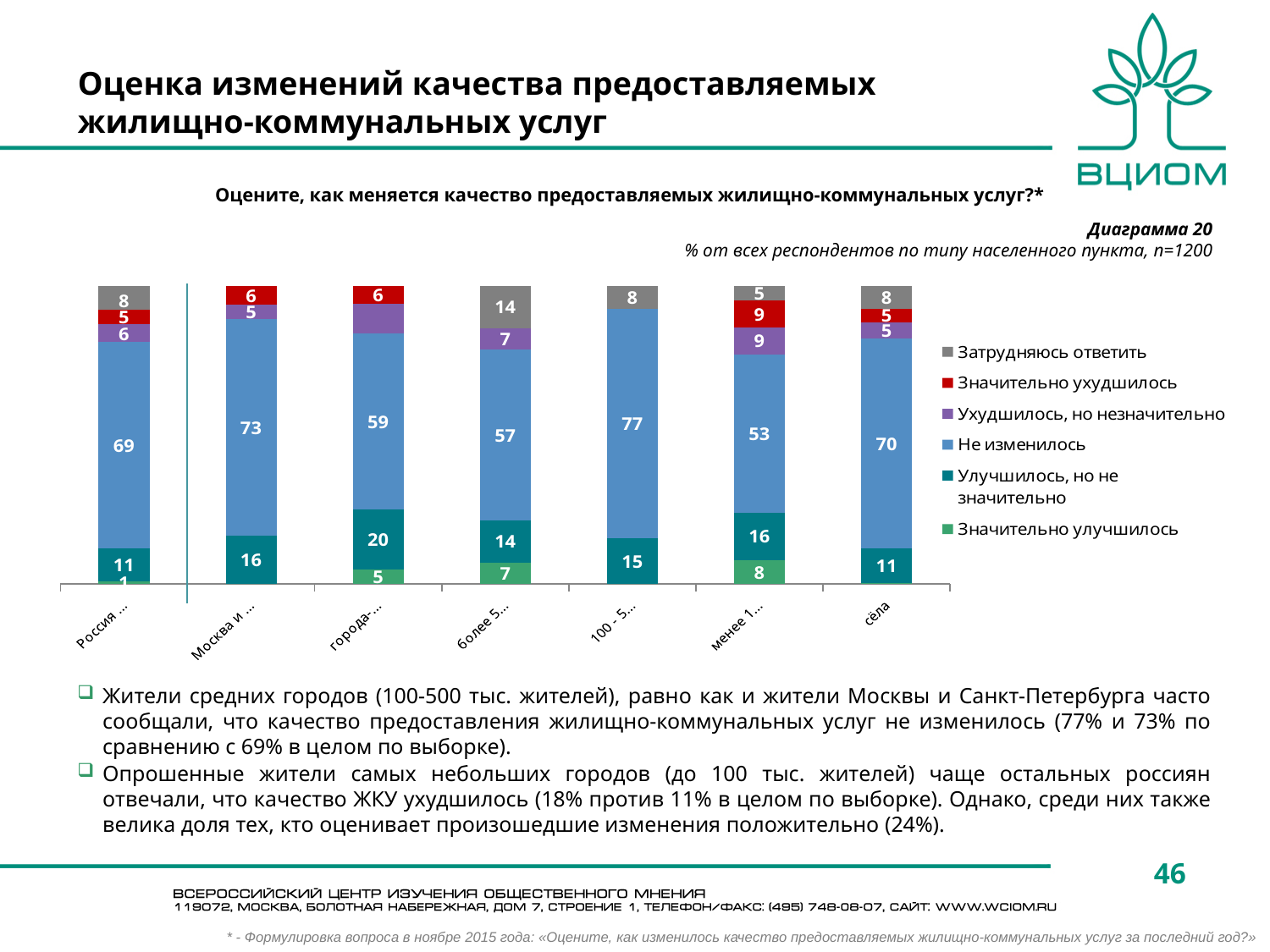
How many categories (bars) are plotted along the x axis? 7 What is the value of "Затрудняюсь ответить" for сёла? 8 What kind of chart is shown on the slide? stacked bar chart Is the "Не изменилось" value for сёла greater or less than 50? greater What is the difference between the "Не изменилось" values for Москва and Россия? 4 What colour represents "Не изменилось" in the legend? blue What is the total of the stacked bar for Россия? 100 How many series does the legend list? 6 What is the value of "Улучшилось, но не значительно" for Москва? 16 Which has a larger "Не изменилось" value, Москва or сёла? Москва What is the value of "Не изменилось" for Россия? 69 What is the value of "Не изменилось" for сёла? 70